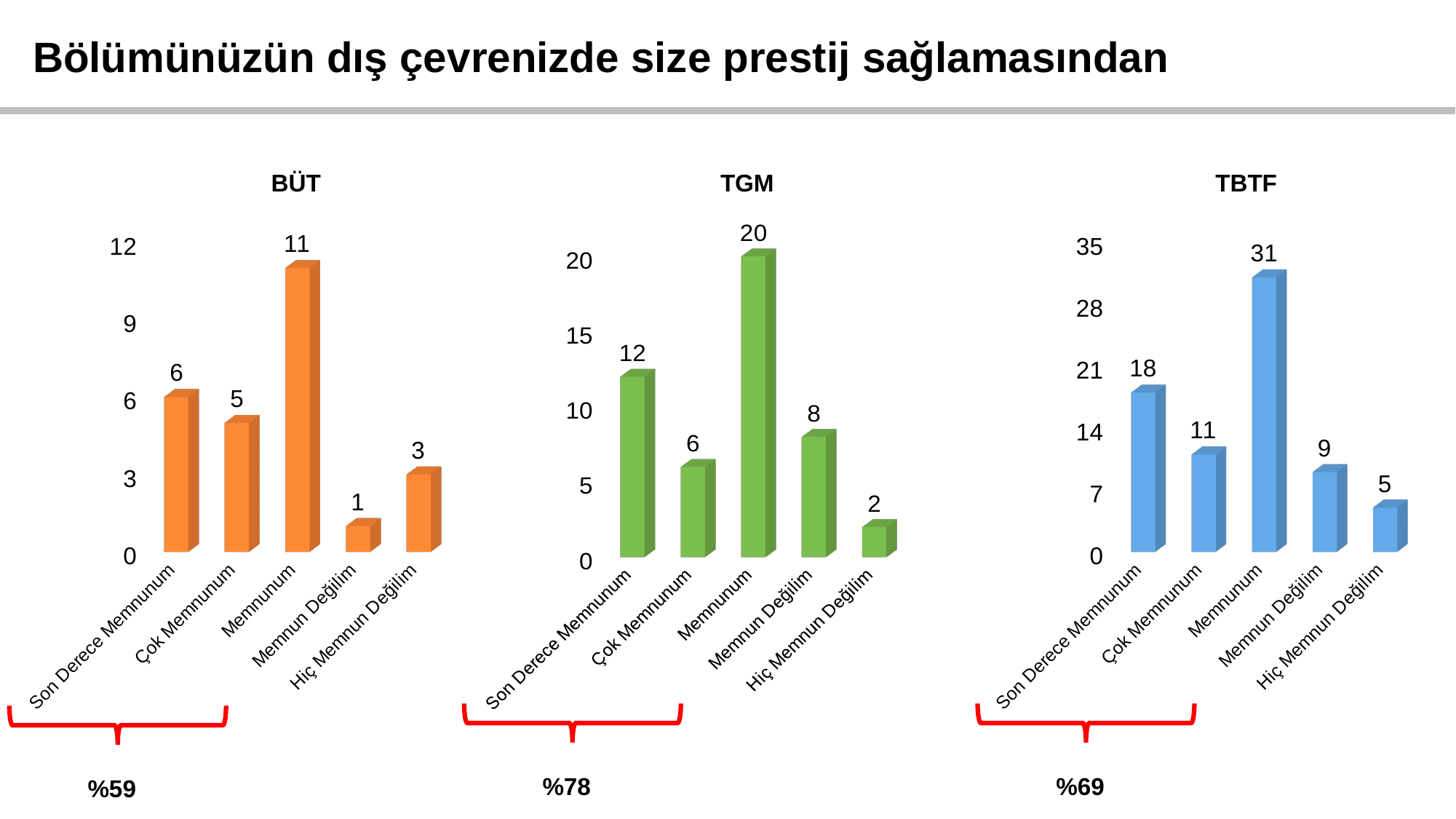
What colour are the bars in the TBTF chart? blue In the TBTF chart, which is larger: the value for Son Derece Memnunum or the value for Çok Memnunum? Son Derece Memnunum What percentage is shown under the bracket beneath the TGM chart? %78 In the TGM chart, is the value for Memnunum greater or less than 15? greater In the BÜT chart, which category has the lowest value? Memnun Değilim In the TBTF chart, what is the value for Hiç Memnun Değilim? 5 In the TGM chart, what is the difference between the values for Memnunum and Memnun Değilim? 12 How many categories are shown in the BÜT chart? 5 In the BÜT chart, what is the value for Memnunum? 11 What kind of chart is the TGM chart? bar chart In the TGM chart, what is the value for Son Derece Memnunum? 12 In the TBTF chart, which category has the highest value? Memnunum